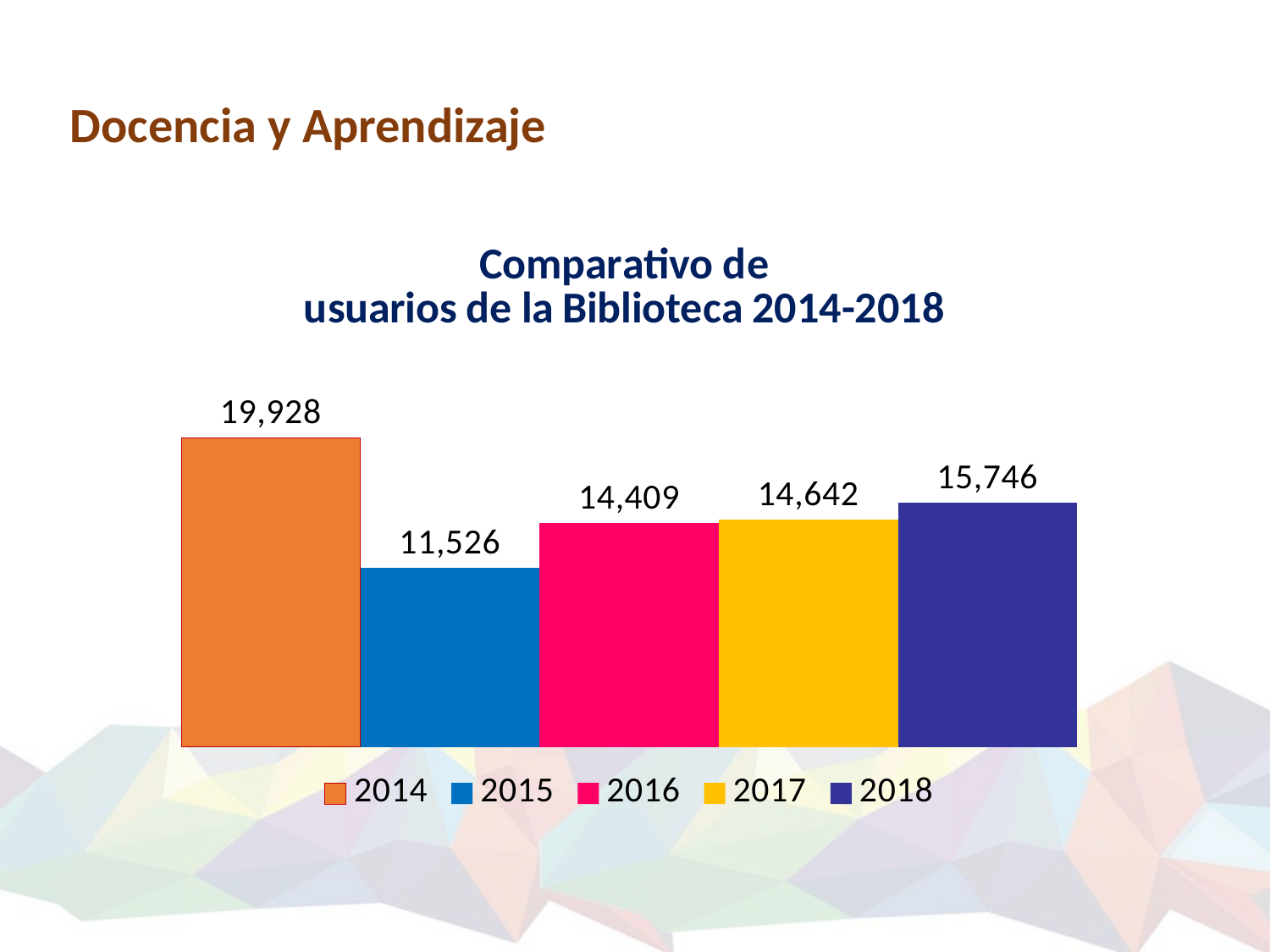
How many entries does the legend list? 5 What is the number of library users shown for 2014? 19,928 What is the difference between the 2014 and 2015 values? 8,402 Which year has the lowest number of library users? 2015 What kind of chart is shown on the slide? Bar chart What is the number of library users shown for 2017? 14,642 How many years are plotted in the chart? 5 Which year has the highest number of library users? 2014 What is the title of the chart? Comparativo de usuarios de la Biblioteca 2014-2018 Which is larger, the value for 2016 or the value for 2018? 2018 What is the number of library users shown for 2015? 11,526 What is the difference between the 2018 and 2017 values? 1,104